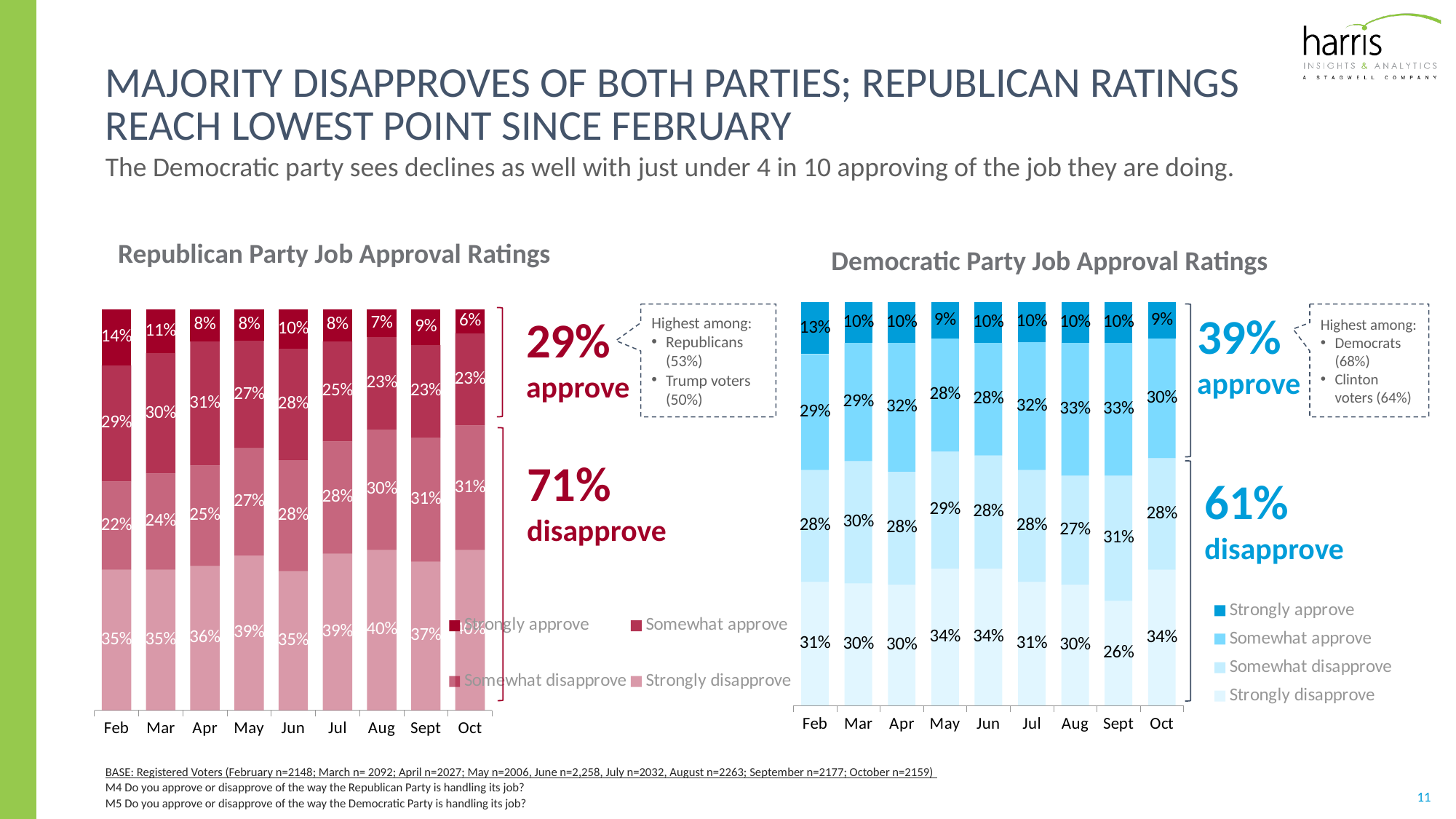
In the Republican Party Job Approval Ratings chart, does the Strongly approve value rise or fall from Feb to Oct? Fall How many series does the legend of the Democratic Party Job Approval Ratings chart list? 4 In the Republican Party Job Approval Ratings chart, what percentage strongly approved in Feb? 14% How many months are shown on the x axis of the Republican Party Job Approval Ratings chart? 9 What kind of chart is the Democratic Party Job Approval Ratings chart? Stacked bar chart In the Republican Party Job Approval Ratings chart, which month has the lowest Strongly approve value? Oct In the Republican Party Job Approval Ratings chart, what is the combined Strongly approve and Somewhat approve total for Oct? 29% In the Democratic Party Job Approval Ratings chart, which month has the lowest Strongly disapprove value? Sept In the Democratic Party Job Approval Ratings chart, what percentage strongly disapproved in Sept? 26% In the Republican Party Job Approval Ratings chart, how many percentage points higher is Somewhat approve in Feb than in Oct? 6 percentage points In the Republican Party Job Approval Ratings chart, which month has the highest Strongly approve value? Feb In the Democratic Party Job Approval Ratings chart, is Somewhat approve higher in Aug or in Feb? Aug